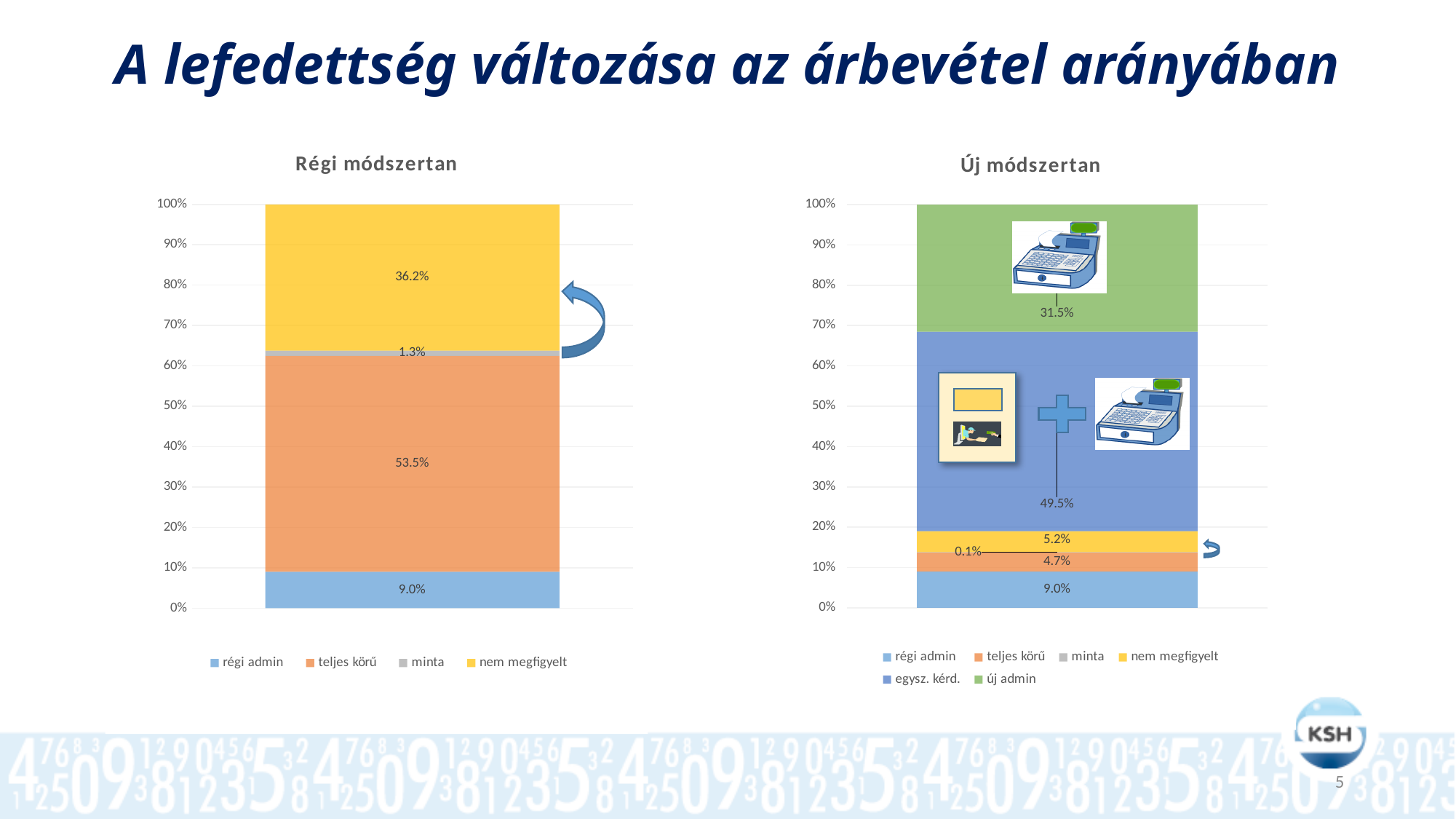
In the 'Új módszertan' chart, which series has the smallest share? minta How many series does the legend of the 'Új módszertan' chart list? 6 In the 'Új módszertan' chart, what is the value for 'új admin'? 31.5% In the 'Új módszertan' chart, what is the value for 'minta'? 0.1% In the 'Régi módszertan' chart, which series has the largest share? teljes körű In the 'Régi módszertan' chart, what is the combined total of 'régi admin' and 'teljes körű'? 62.5% In the 'Új módszertan' chart, which is larger: 'nem megfigyelt' or 'teljes körű'? nem megfigyelt In the 'Új módszertan' chart, what is the value for 'egysz. kérd.'? 49.5% What is the difference between the 'teljes körű' value in the 'Régi módszertan' chart and the 'teljes körű' value in the 'Új módszertan' chart? 48.8% In the 'Régi módszertan' chart, what is the value for 'nem megfigyelt'? 36.2% In the 'Régi módszertan' chart, what is the value for 'teljes körű'? 53.5% What kind of chart is the 'Régi módszertan' chart? Stacked bar chart